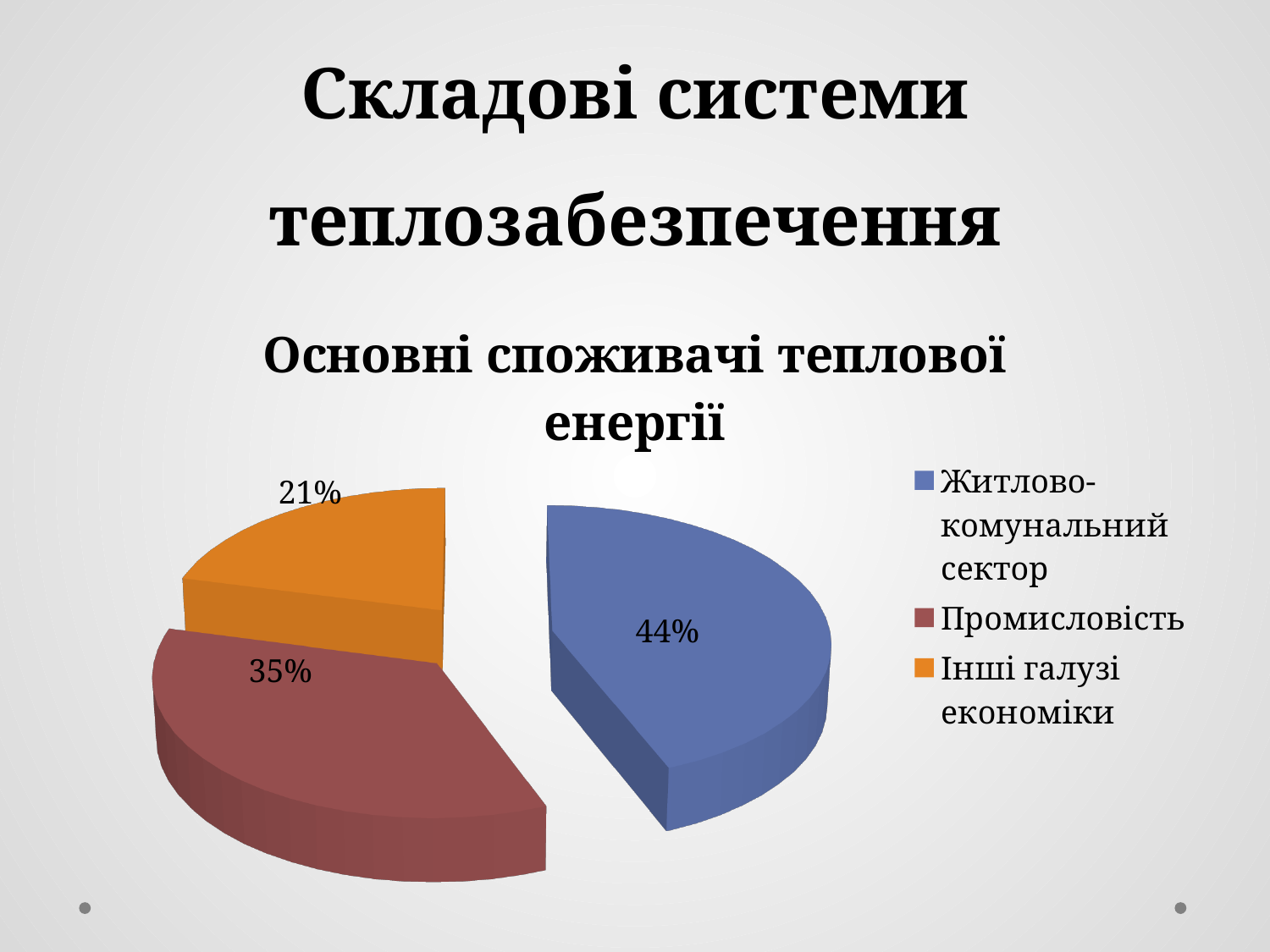
How many slices does the pie chart have? 3 Which category has the smallest share of the pie? Інші галузі економіки What kind of chart is shown on the slide? Pie chart What is the difference in percentage points between Промисловість and Інші галузі економіки? 14 What share of the pie does Промисловість have? 35% What share of the pie does Інші галузі економіки have? 21% Which is larger, the share for Промисловість or the share for Інші галузі економіки? Промисловість What share of the pie does Житлово-комунальний сектор have? 44% What is the title of the chart? Основні споживачі теплової енергії Which category has the largest share of the pie? Житлово-комунальний сектор What colour is the slice for Промисловість? Red What is the difference in percentage points between Житлово-комунальний сектор and Промисловість? 9